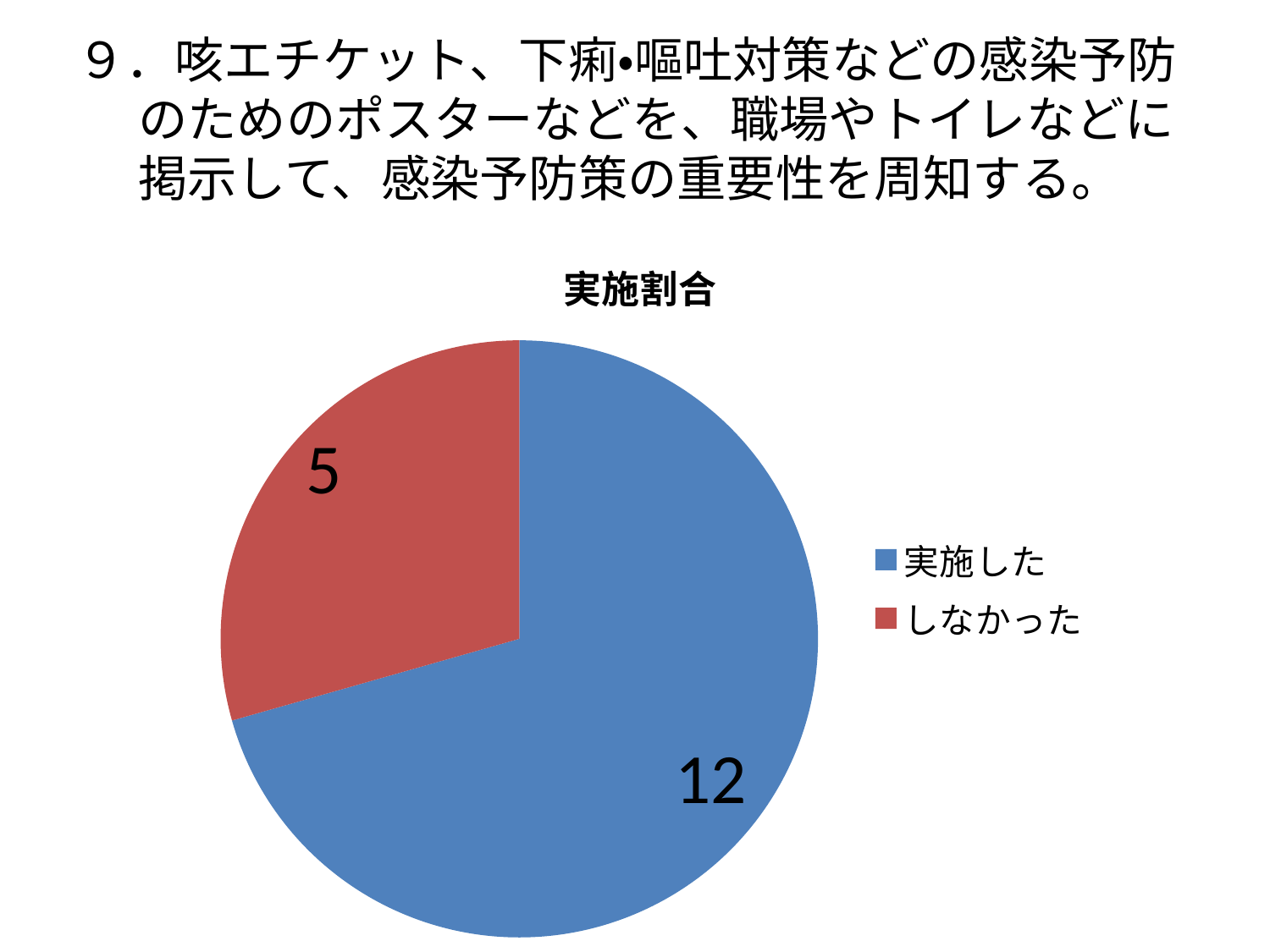
What is the title of the chart? 実施割合 Which is larger, 実施した or しなかった? 実施した What kind of chart is shown on the slide? pie chart What colour is the slice for しなかった? red What is the total of all slices in the pie chart? 17 Which category has the largest slice? 実施した How many categories does the pie chart show? 2 What is the value for 実施した? 12 Which category has the smallest slice? しなかった What is the difference between the values for 実施した and しなかった? 7 What is the value for しなかった? 5